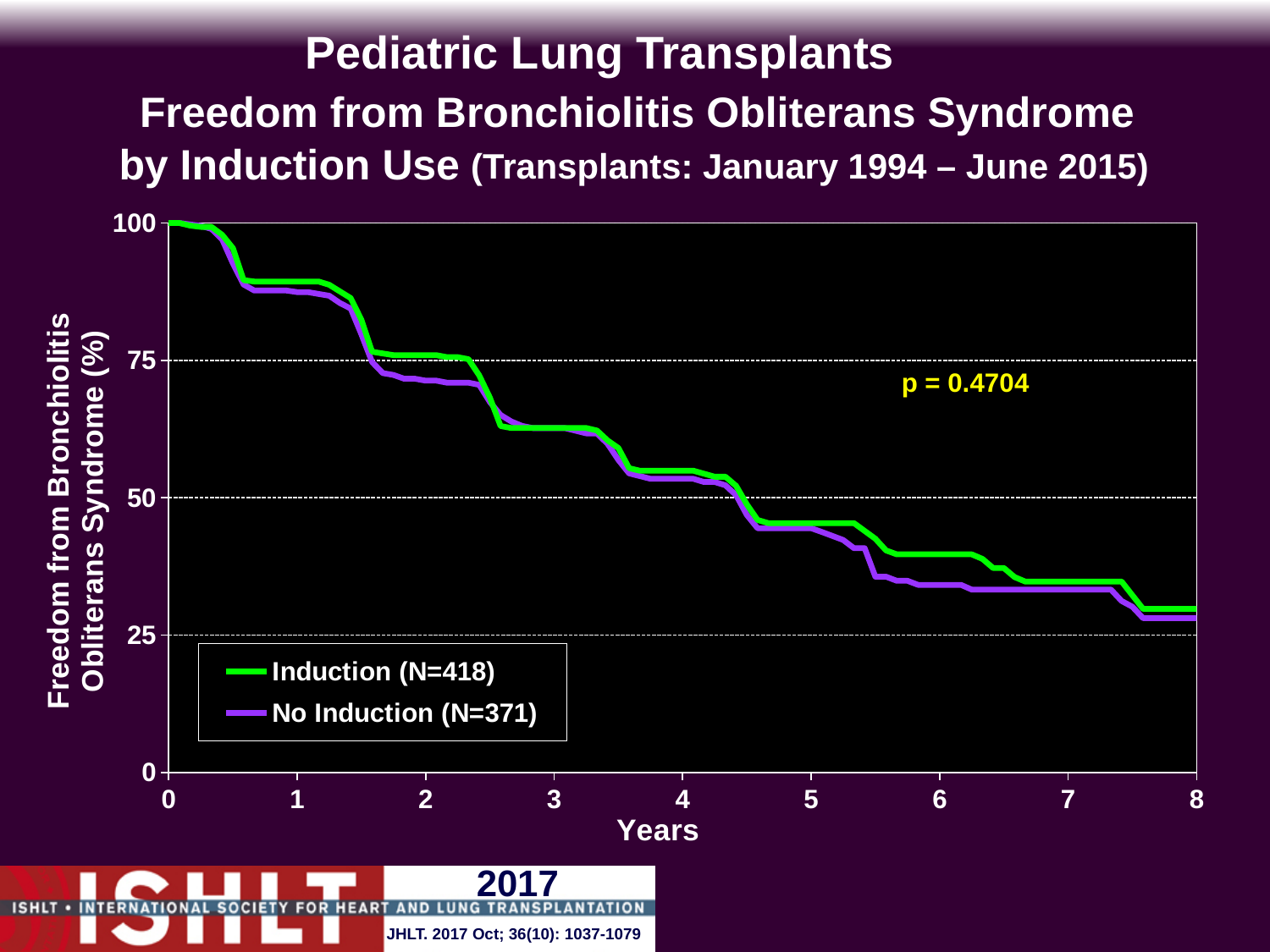
How many series does the legend list? 2 Is the value for Induction at year 4 greater or less than 50? greater Is the value for Induction at year 8 greater or less than 25? greater Is the value for No Induction at year 3 greater or less than 50? greater What kind of chart is shown on the slide? line chart At year 6, which series has the higher value, Induction or No Induction? Induction What are the two series named in the legend? Induction (N=418) and No Induction (N=371) What p-value is printed on the chart? p = 0.4704 Do the values for the Induction series rise or fall as years increase? fall